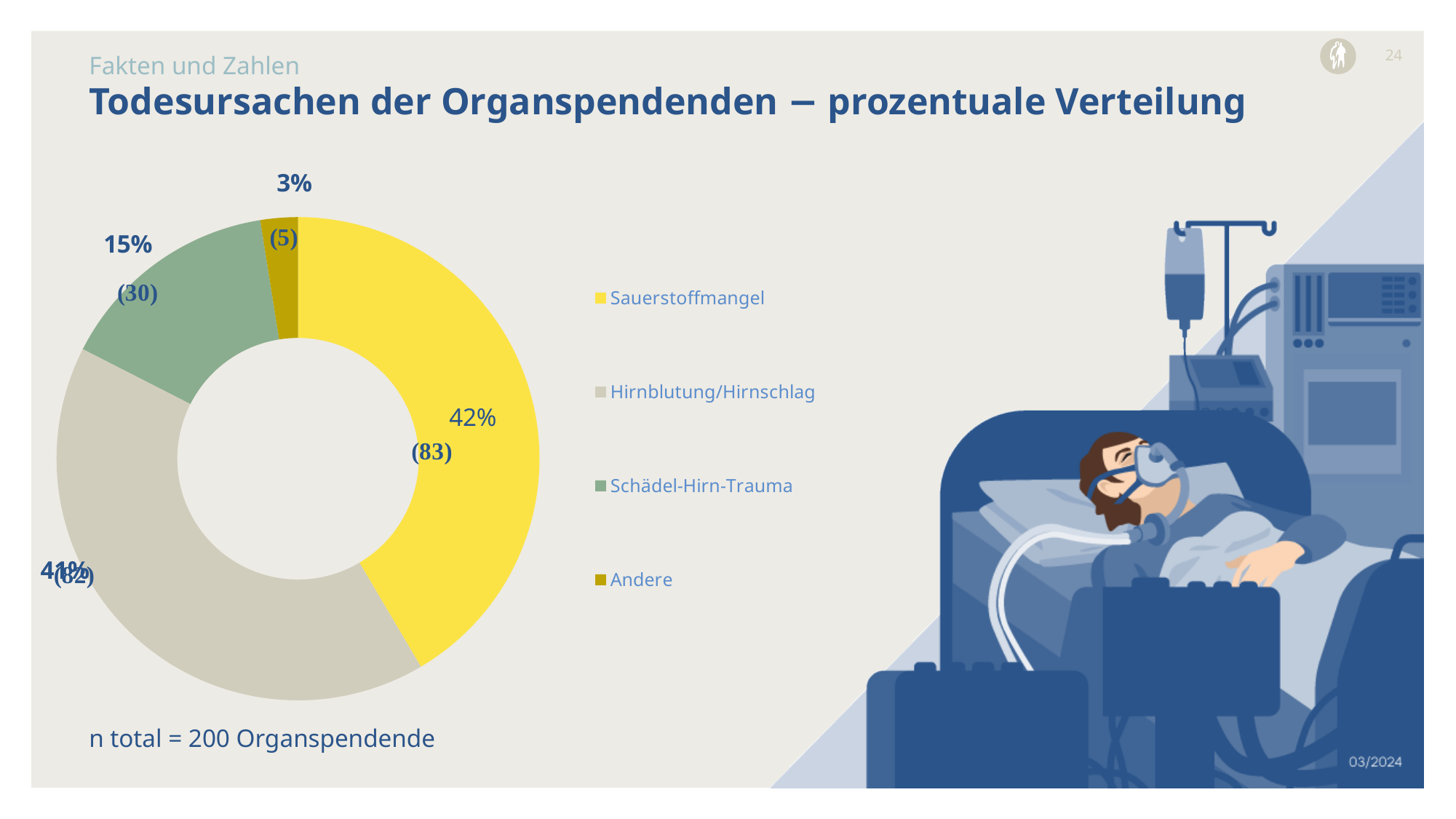
Which cause of death has the smallest share of the chart? Andere How many categories does the chart show? 4 What kind of chart is shown on the slide? pie chart (donut) What percentage is shown for Schädel-Hirn-Trauma? 15% By how many percentage points does Schädel-Hirn-Trauma exceed Andere? 12 percentage points What percentage is shown for Andere? 3% What is the total number of organ donors (n total) stated on the slide? 200 Organspendende Which cause of death has the largest share of the chart? Sauerstoffmangel How many donors (number in parentheses) are attributed to Sauerstoffmangel? 83 How many donors (number in parentheses) are attributed to Schädel-Hirn-Trauma? 30 What percentage of organ donors died of Sauerstoffmangel? 42% What percentage is shown for Hirnblutung/Hirnschlag? 41%